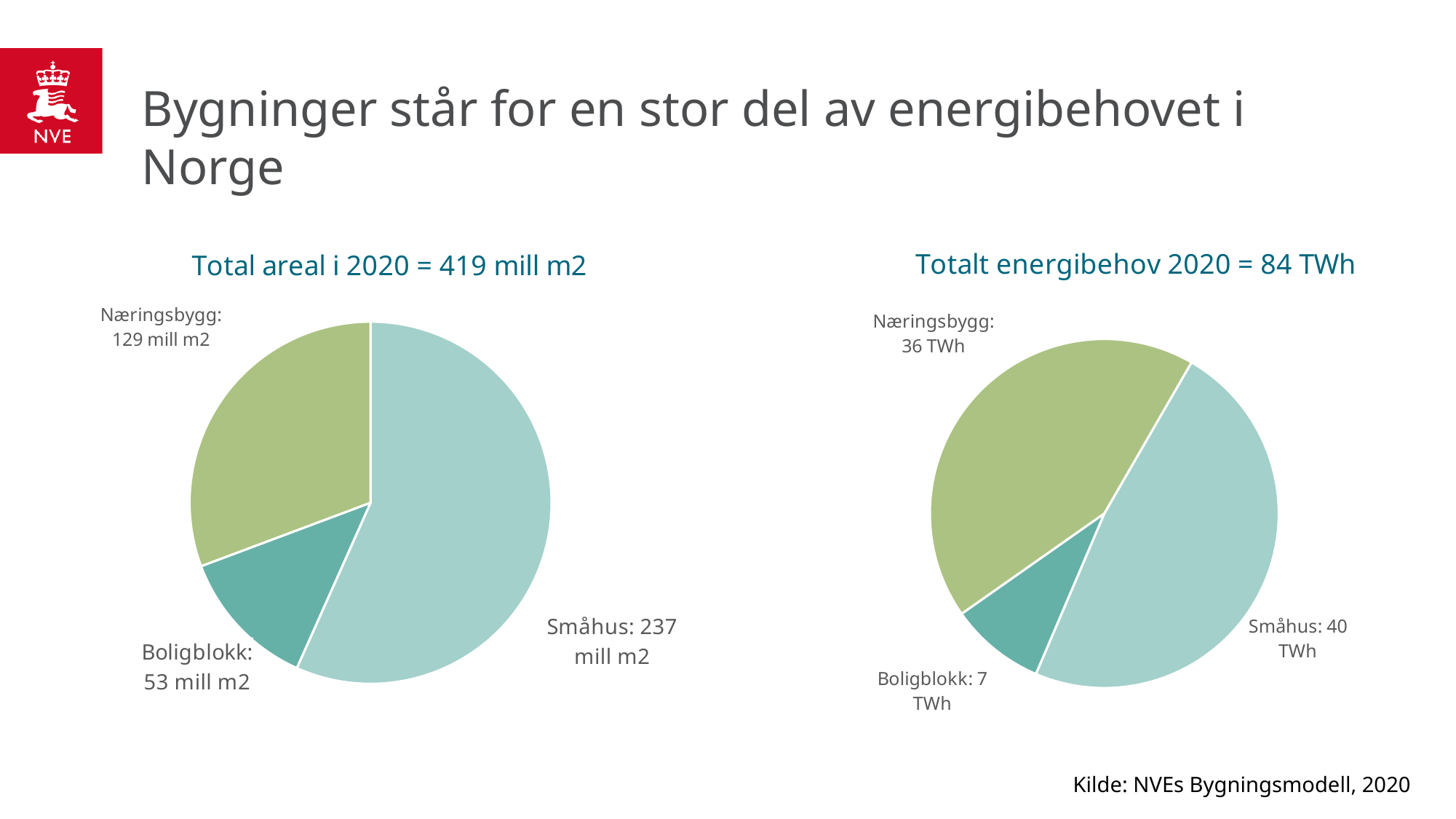
How many slices does the left pie chart 'Total areal i 2020 = 419 mill m2' have? 3 In the left pie chart 'Total areal i 2020 = 419 mill m2', what is the value for Boligblokk? 53 mill m2 In the right pie chart 'Totalt energibehov 2020 = 84 TWh', what is the value for Næringsbygg? 36 TWh What is the title of the right pie chart on the slide? Totalt energibehov 2020 = 84 TWh In the right pie chart 'Totalt energibehov 2020 = 84 TWh', what is the difference between Småhus and Boligblokk? 33 TWh In the left pie chart 'Total areal i 2020 = 419 mill m2', what is the value for Småhus? 237 mill m2 In the right pie chart 'Totalt energibehov 2020 = 84 TWh', which is larger: Småhus or Næringsbygg? Småhus What type of chart is used on the left side of the slide, titled 'Total areal i 2020 = 419 mill m2'? Pie chart In the left pie chart 'Total areal i 2020 = 419 mill m2', which category has the largest value? Småhus In the right pie chart 'Totalt energibehov 2020 = 84 TWh', which category has the smallest value? Boligblokk In the left pie chart 'Total areal i 2020 = 419 mill m2', what is the difference between Småhus and Næringsbygg? 108 mill m2